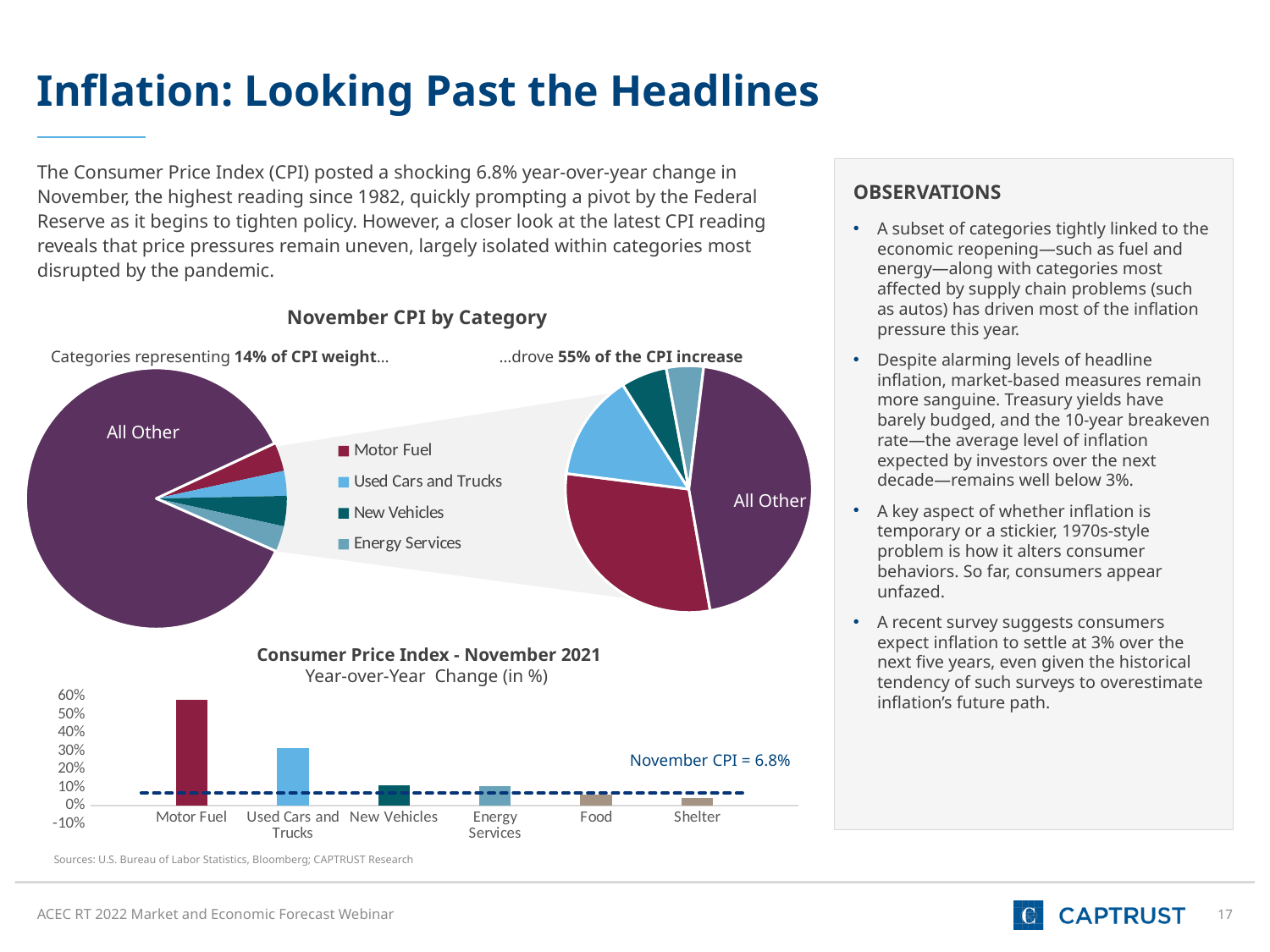
How many categories are shown in the 'Consumer Price Index - November 2021' bar chart? 6 In the 'Consumer Price Index - November 2021' bar chart, which is larger: Motor Fuel or Used Cars and Trucks? Motor Fuel In the 'Consumer Price Index - November 2021' bar chart, is the value for Used Cars and Trucks greater or less than 40%? less According to the 'November CPI by Category' chart, what share of the CPI increase did the highlighted categories drive? 55% How many entries does the legend between the two pie charts in 'November CPI by Category' list? 4 What kind of chart is the 'Consumer Price Index - November 2021' chart at the bottom of the slide? bar chart In the 'Consumer Price Index - November 2021' bar chart, what value is given for the November CPI dashed line? 6.8% In the right pie chart of 'November CPI by Category', which is larger: the Motor Fuel slice or the Used Cars and Trucks slice? Motor Fuel In the 'Consumer Price Index - November 2021' bar chart, is the value for Shelter greater or less than 10%? less In the left pie chart of 'November CPI by Category', which slice is the largest? All Other In the 'Consumer Price Index - November 2021' bar chart, which category has the highest year-over-year change? Motor Fuel In the 'Consumer Price Index - November 2021' bar chart, is the value for Motor Fuel greater or less than 50%? greater